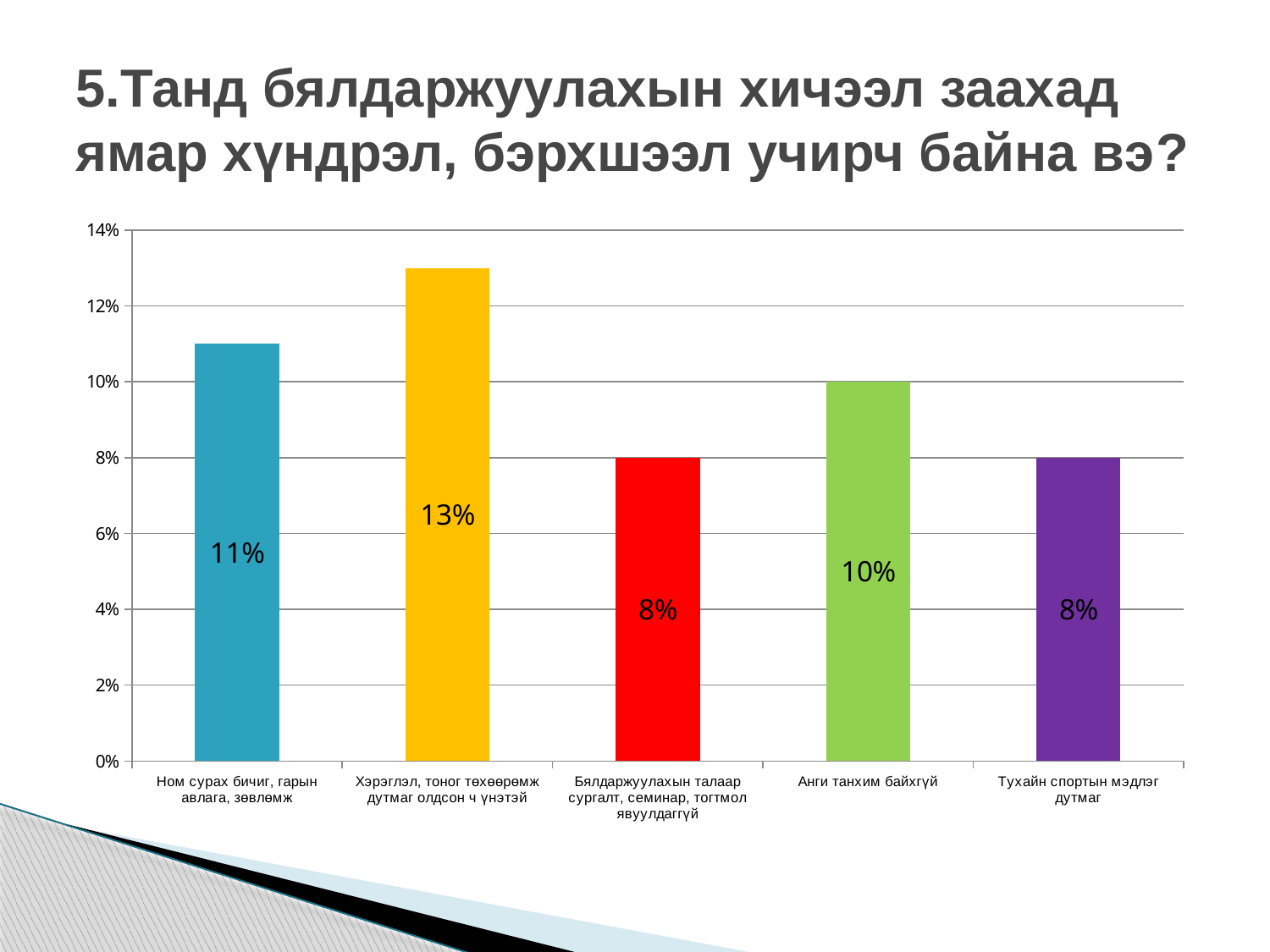
What is the value for "Бялдаржуулахын талаар сургалт, семинар, тогтмол явуулдаггүй"? 8% How many categories are plotted in the chart? 5 What kind of chart is shown on the slide? bar chart What is the value for "Анги танхим байхгүй"? 10% Which is larger, the value for "Ном сурах бичиг, гарын авлага, зөвлөмж" or the value for "Анги танхим байхгүй"? Ном сурах бичиг, гарын авлага, зөвлөмж Is the value for "Хэрэглэл, тоног төхөөрөмж дутмаг олдсон ч үнэтэй" greater or less than 12%? greater What is the value for "Тухайн спортын мэдлэг дутмаг"? 8% What is the value for "Ном сурах бичиг, гарын авлага, зөвлөмж"? 11% What colour is the bar for "Бялдаржуулахын талаар сургалт, семинар, тогтмол явуулдаггүй"? red Which category has the highest value? Хэрэглэл, тоног төхөөрөмж дутмаг олдсон ч үнэтэй What is the difference between the values for "Хэрэглэл, тоног төхөөрөмж дутмаг олдсон ч үнэтэй" and "Анги танхим байхгүй"? 3% What is the value for "Хэрэглэл, тоног төхөөрөмж дутмаг олдсон ч үнэтэй"? 13%